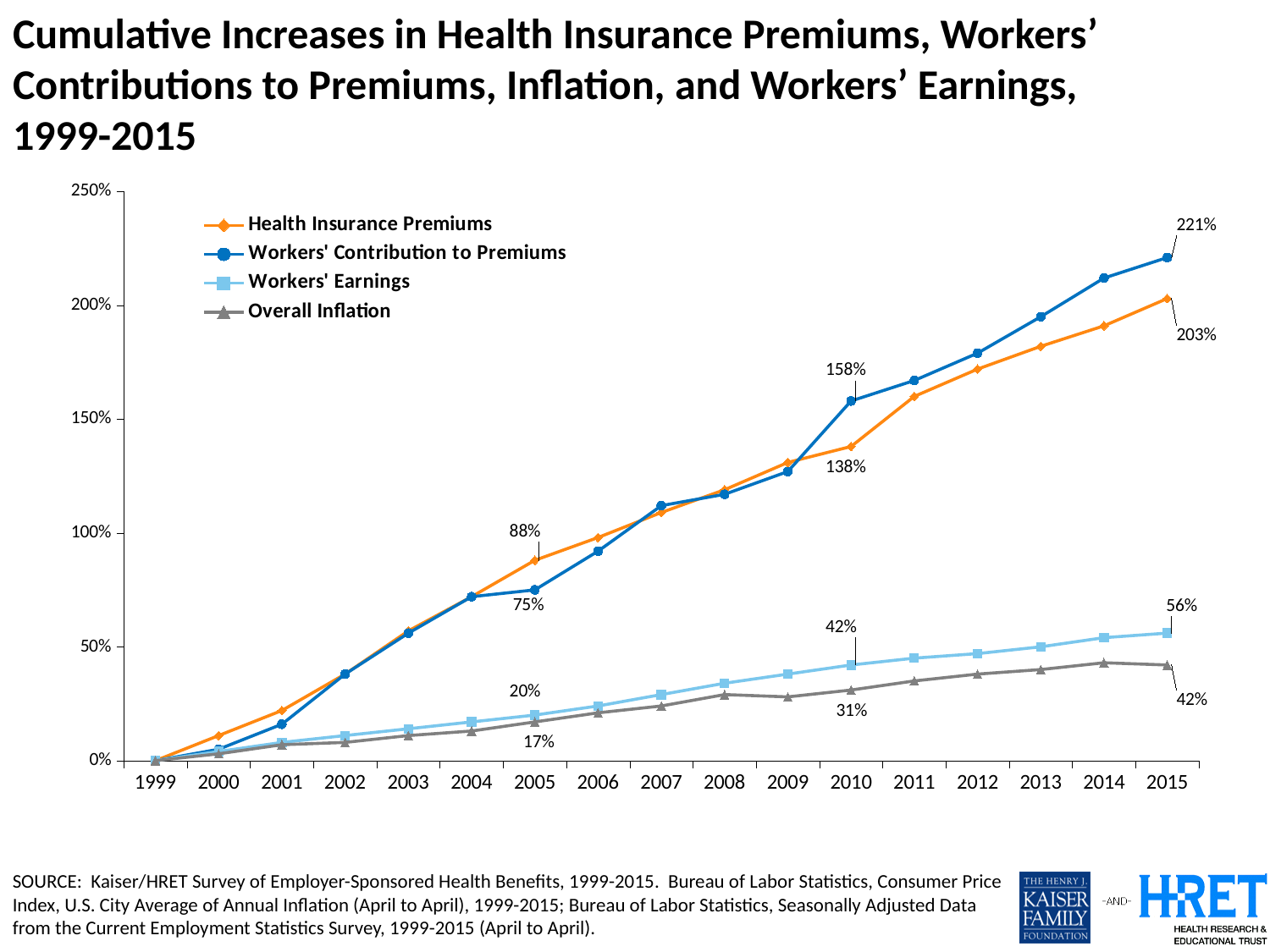
Which series has the highest value in 2015? Workers' Contribution to Premiums Is the value for Health Insurance Premiums in 2012 greater or less than 150%? greater How many years are plotted along the x axis? 17 In 2010, which is larger: Workers' Contribution to Premiums or Health Insurance Premiums? Workers' Contribution to Premiums What is the value for Overall Inflation in 2005? 17% What is the cumulative increase in Workers' Contribution to Premiums in 2015? 221% What is the cumulative increase in Health Insurance Premiums in 2015? 203% What kind of chart is shown on the slide? Line chart What is the value for Workers' Earnings in 2010? 42% What is the value for Workers' Contribution to Premiums in 2005? 75% In 2015, how many percentage points higher is Workers' Contribution to Premiums than Health Insurance Premiums? 18 percentage points How many series does the legend list? 4